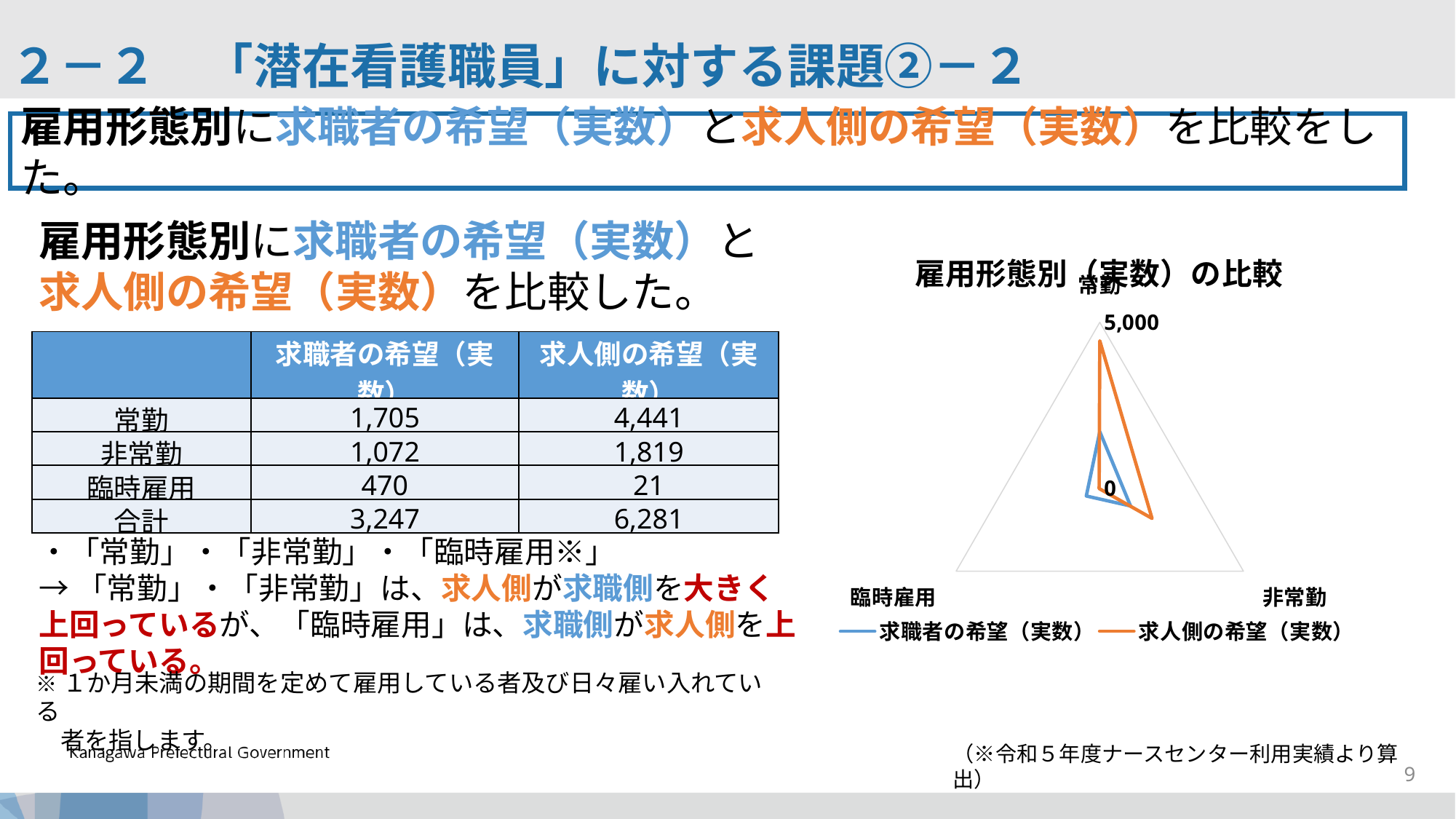
Is the value of 求人側の希望（実数） for 非常勤 greater or less than 5,000? less How many categories (axes) does the radar chart have? 3 What is the difference between 求人側の希望（実数） and 求職者の希望（実数） for 常勤? 2,736 For which category is 求人側の希望（実数） lowest? 臨時雇用 Which series is drawn in orange in the chart? 求人側の希望（実数） What kind of chart is shown on the slide? Radar chart What is the title of the chart on the slide? 雇用形態別（実数）の比較 For 臨時雇用, which is larger: 求職者の希望（実数） or 求人側の希望（実数）? 求職者の希望（実数） For which category is 求人側の希望（実数） highest? 常勤 What is the value of 求職者の希望（実数） for 臨時雇用? 470 What is the value of 求人側の希望（実数） for 常勤? 4,441 How many series does the chart's legend list? 2